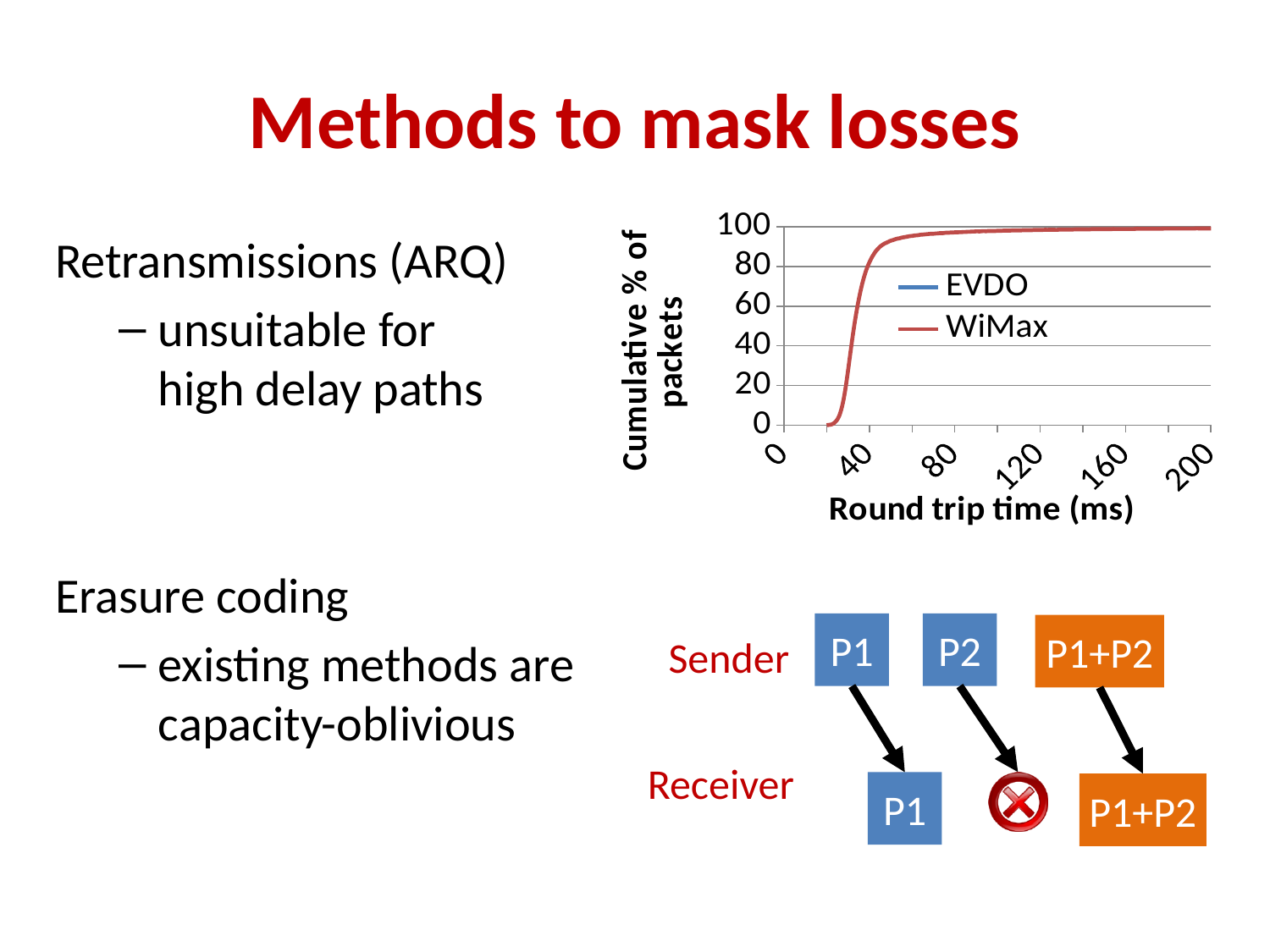
What is the title of the chart's x axis? Round trip time (ms) Is the cumulative % of packets for WiMax at a round trip time of 80 ms greater or less than 80? greater How many series does the chart's legend list? 2 Is the cumulative % of packets for EVDO at a round trip time of 20 ms greater or less than 20? less Is the cumulative % of packets for WiMax at a round trip time of 160 ms greater or less than 80? greater What kind of chart is shown on the slide? line chart What is the highest value shown on the chart's x axis? 200 Do the plotted values rise or fall as round trip time increases along the x axis? rise What are the two series named in the chart's legend? EVDO and WiMax